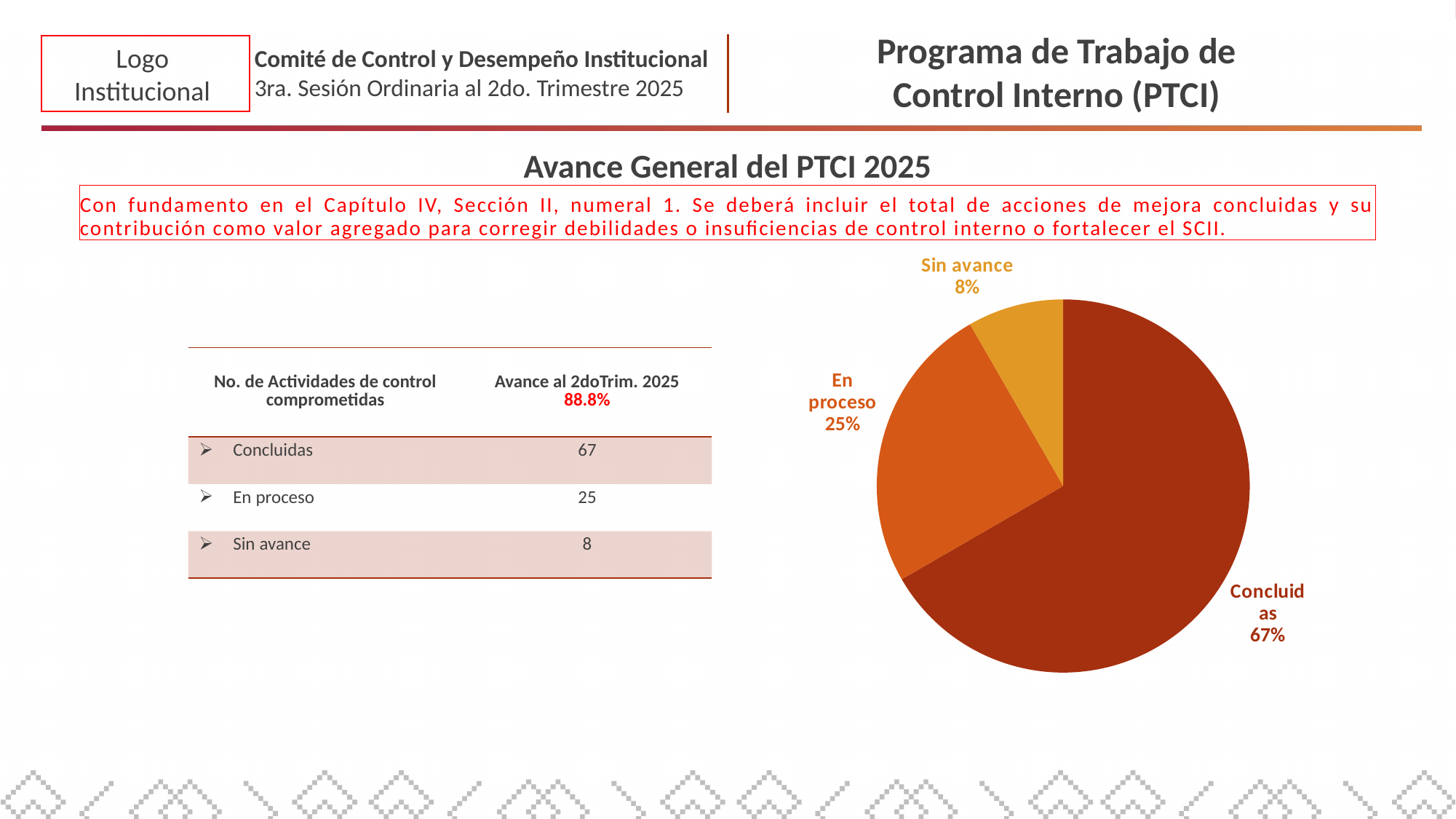
What colour is the Concluidas slice of the pie chart? dark red-brown What is the difference in percentage points between the En proceso and Sin avance slices of the pie chart? 17 Which slice of the pie chart is the smallest? Sin avance Which slice of the pie chart is the largest? Concluidas What is the difference in percentage points between the Concluidas and En proceso slices of the pie chart? 42 What share of the pie chart is labelled En proceso? 25% What kind of chart is shown on the slide? pie chart What share of the pie chart is labelled Sin avance? 8% How many slices does the pie chart have? 3 What share of the pie chart is labelled Concluidas? 67% What colour is the Sin avance slice of the pie chart? yellow-orange In the pie chart, which is larger: En proceso or Sin avance? En proceso